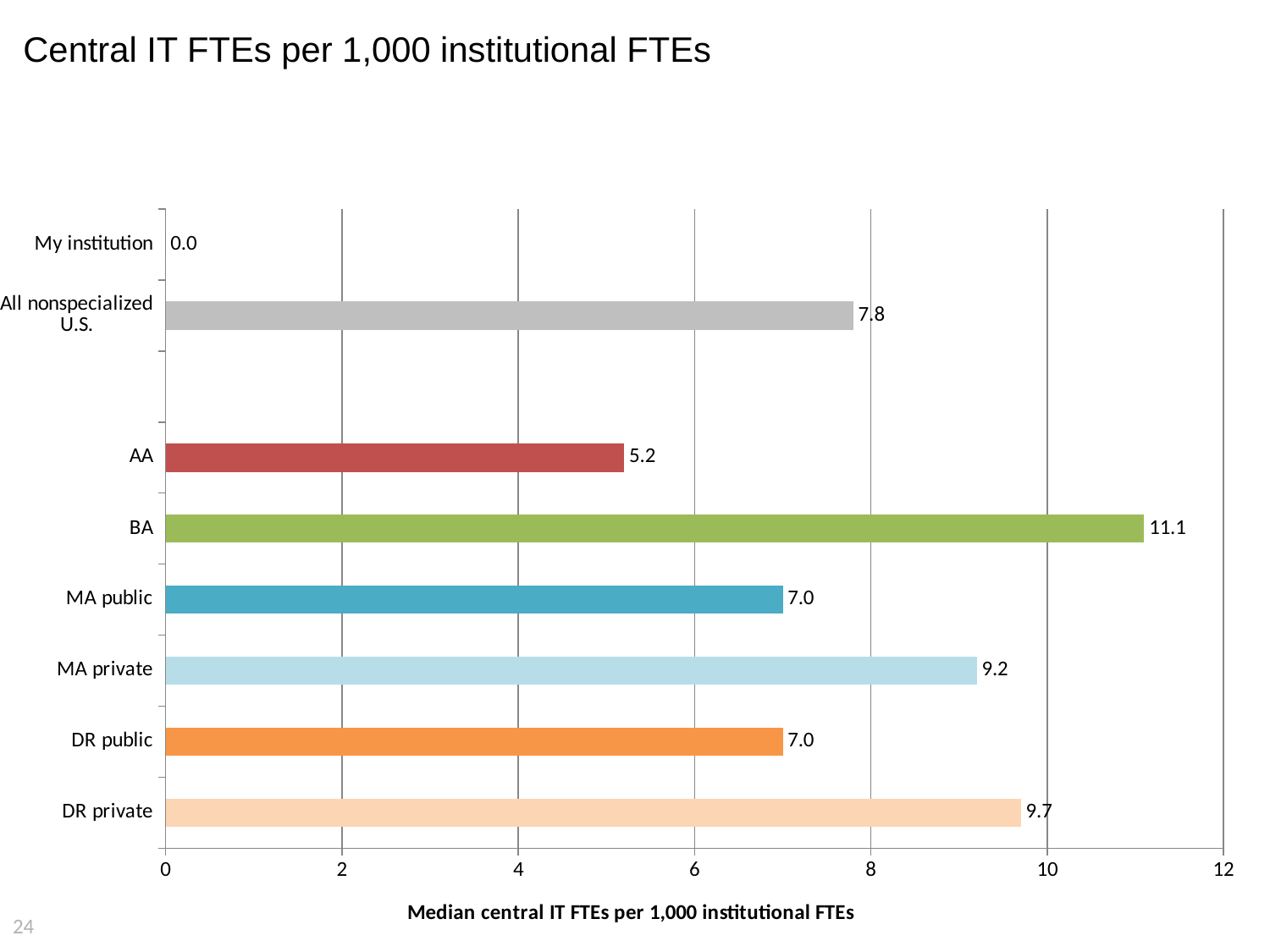
What is the difference between the values for DR private and DR public? 2.7 What kind of chart is shown on the slide? Bar chart What is the value for My institution? 0.0 What is the x-axis title of the chart? Median central IT FTEs per 1,000 institutional FTEs Which is larger, the value for MA private or the value for MA public? MA private What is the value for All nonspecialized U.S.? 7.8 How many categories are shown on the chart? 8 What is the value for DR private? 9.7 Which category has the highest value? BA What is the value for BA? 11.1 Which category has the lowest value? My institution What is the difference between the values for BA and AA? 5.9